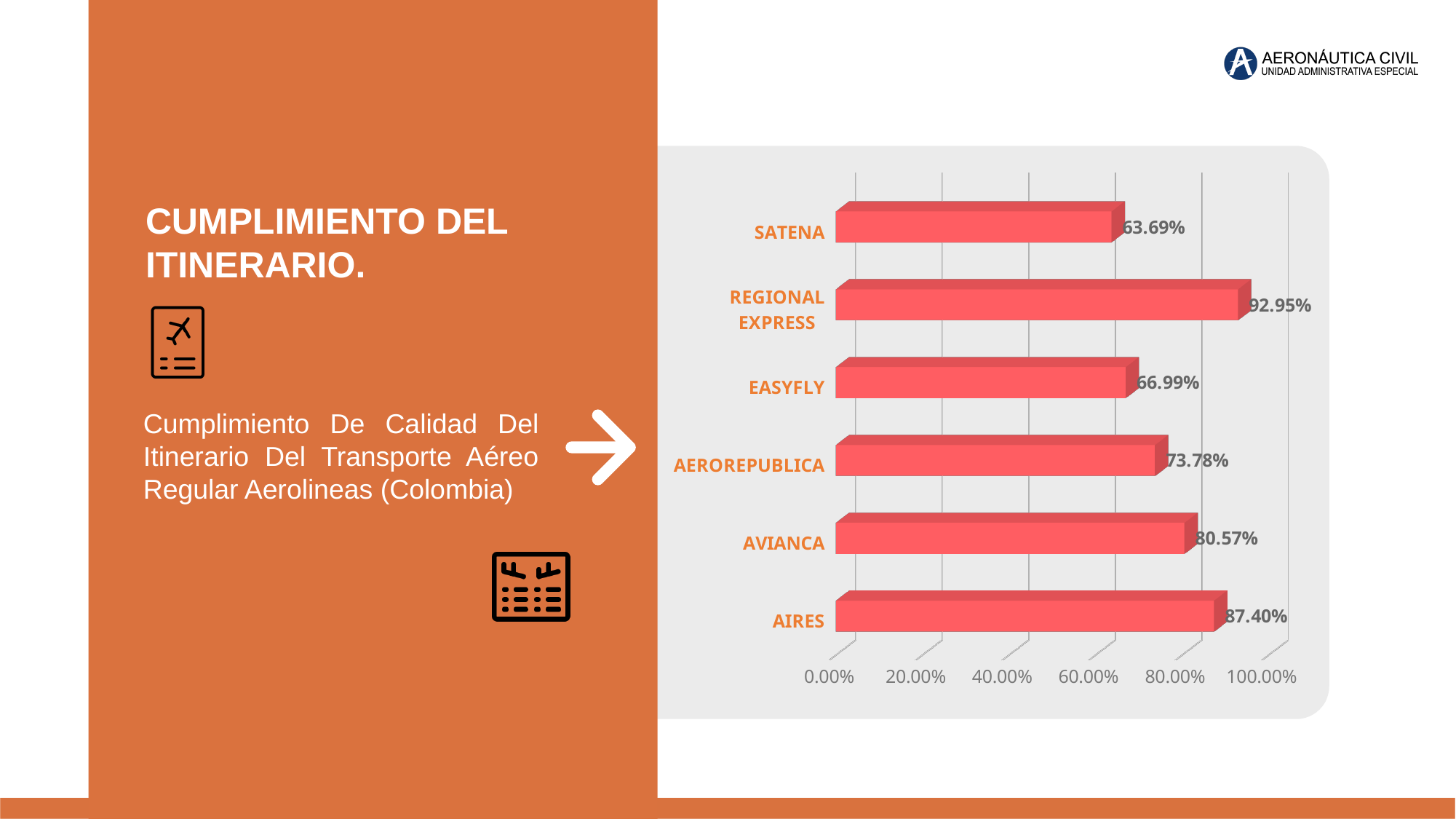
What is the value for REGIONAL EXPRESS? 92.95% How many airlines are shown in the chart? 6 What kind of chart is shown on the slide? bar chart Which airline has the highest value? REGIONAL EXPRESS Which is larger, the value for EASYFLY or the value for AEROREPUBLICA? AEROREPUBLICA What is the value for AIRES? 87.40% Which airline has the lowest value? SATENA What is the difference between the values for REGIONAL EXPRESS and SATENA? 29.26% What is the value for AEROREPUBLICA? 73.78% What is the value for SATENA? 63.69% What is the difference between the values for AIRES and AVIANCA? 6.83% Is the value for AVIANCA greater or less than 80.00%? greater